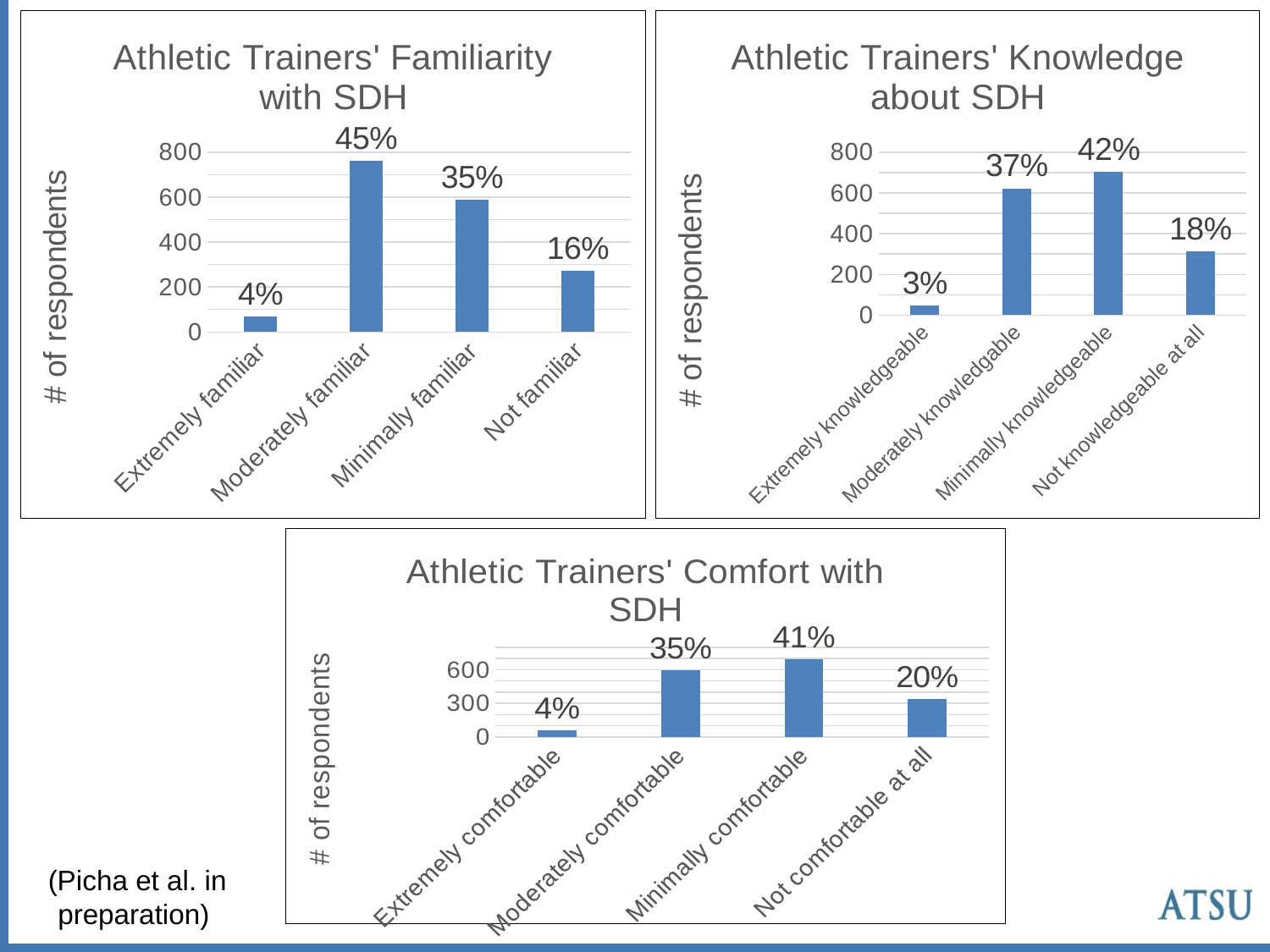
In the 'Athletic Trainers' Knowledge about SDH' chart, is the number of respondents for Extremely knowledgeable greater or less than 200? less In the 'Athletic Trainers' Knowledge about SDH' chart, what is the difference between the Minimally knowledgeable and Moderately knowledgable percentages? 5% In the 'Athletic Trainers' Familiarity with SDH' chart, what is the difference between the Moderately familiar and Minimally familiar percentages? 10% In the 'Athletic Trainers' Familiarity with SDH' chart, which category has the lowest value? Extremely familiar In the 'Athletic Trainers' Comfort with SDH' chart, which is larger, Moderately comfortable or Not comfortable at all? Moderately comfortable In the 'Athletic Trainers' Knowledge about SDH' chart, what is the data label for Not knowledgeable at all? 18% In the 'Athletic Trainers' Familiarity with SDH' chart, is the number of respondents for Moderately familiar greater or less than 600? greater In the 'Athletic Trainers' Knowledge about SDH' chart, which category has the highest value? Minimally knowledgeable How many categories are shown in the 'Athletic Trainers' Comfort with SDH' chart? 4 What type of chart is 'Athletic Trainers' Comfort with SDH'? Bar chart In the 'Athletic Trainers' Comfort with SDH' chart, what is the data label for Minimally comfortable? 41% In the 'Athletic Trainers' Familiarity with SDH' chart, what is the data label for Moderately familiar? 45%